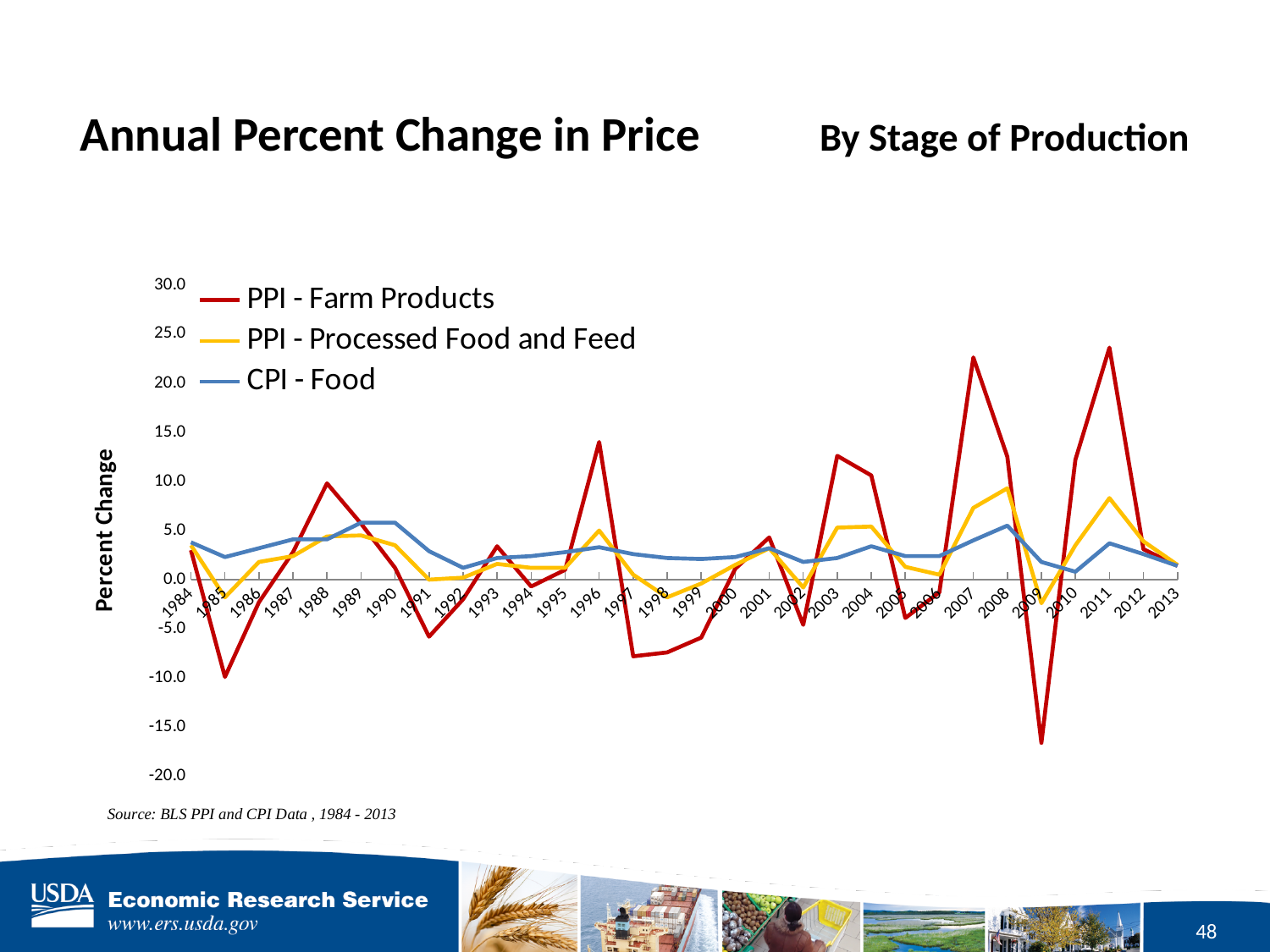
How many years are plotted along the x axis? 30 In 2011, which is larger: PPI - Farm Products or CPI - Food? PPI - Farm Products Is the value for PPI - Farm Products in 2009 greater or less than -15.0? less What is the label on the y axis? Percent Change How many series does the legend list? 3 Which series shows the largest swings from year to year? PPI - Farm Products Is the value for CPI - Food in 2010 greater or less than 5.0? less In which year does PPI - Farm Products reach its lowest value? 2009 Is the value for PPI - Farm Products in 2011 greater or less than 20.0? greater What kind of chart is shown on the slide? line chart